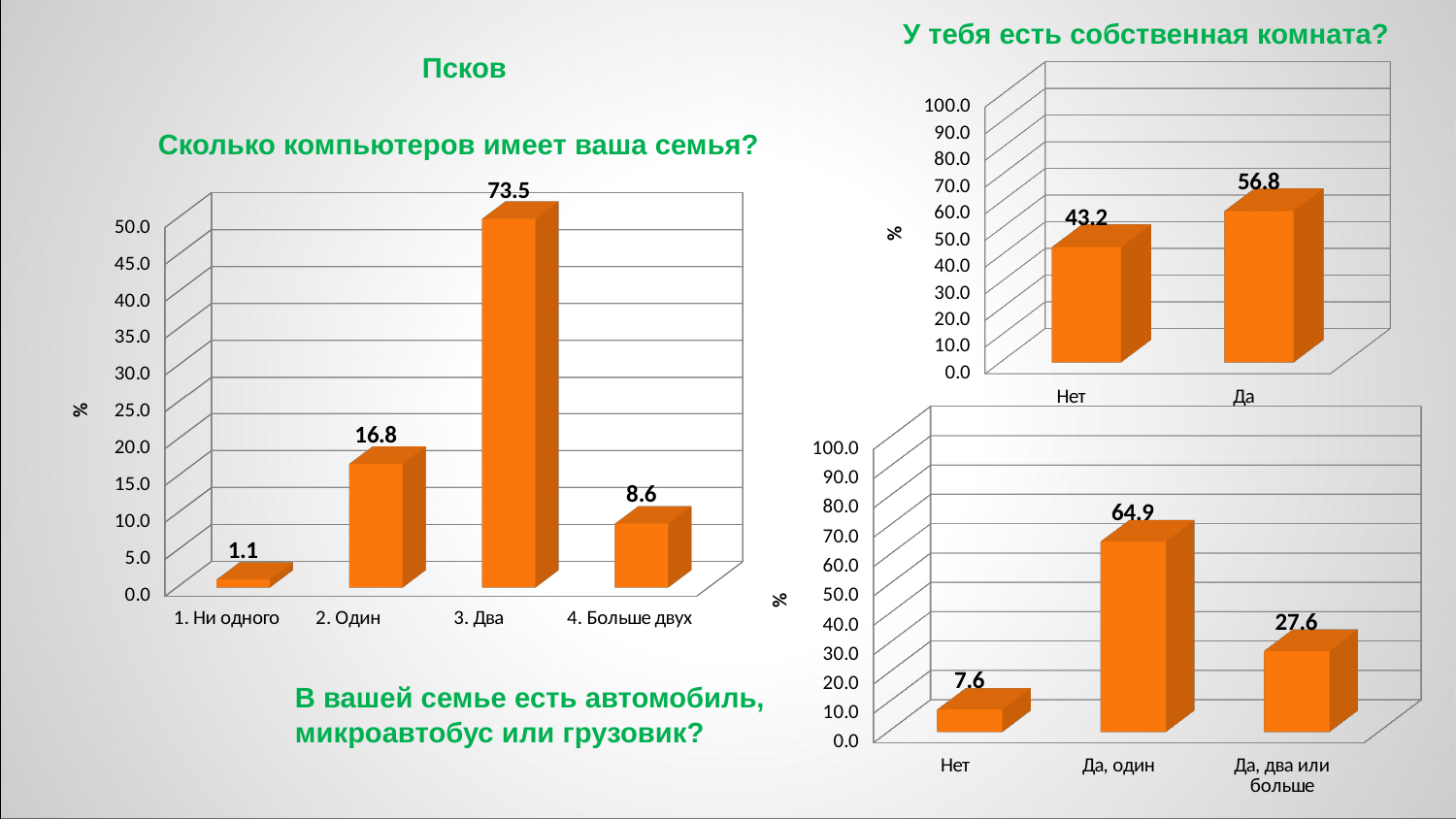
What type of chart is used for 'В вашей семье есть автомобиль, микроавтобус или грузовик?'? Bar chart In the chart 'У тебя есть собственная комната?', which is larger, 'Нет' or 'Да'? Да In the chart 'Сколько компьютеров имеет ваша семья?', which category has the lowest value? 1. Ни одного In the chart 'У тебя есть собственная комната?', what is the value for 'Да'? 56.8 In the chart 'В вашей семье есть автомобиль, микроавтобус или грузовик?', what is the value for 'Нет'? 7.6 In the chart 'У тебя есть собственная комната?', what is the total of the two bars? 100.0 Which city is named at the top of the slide? Псков How many categories are shown in the chart 'Сколько компьютеров имеет ваша семья?'? 4 In the chart 'В вашей семье есть автомобиль, микроавтобус или грузовик?', which category has the highest value? Да, один In the chart 'Сколько компьютеров имеет ваша семья?', what is the value for '3. Два'? 73.5 In the chart 'В вашей семье есть автомобиль, микроавтобус или грузовик?', what is the difference between 'Да, один' and 'Да, два или больше'? 37.3 In the chart 'Сколько компьютеров имеет ваша семья?', what is the difference between '2. Один' and '4. Больше двух'? 8.2